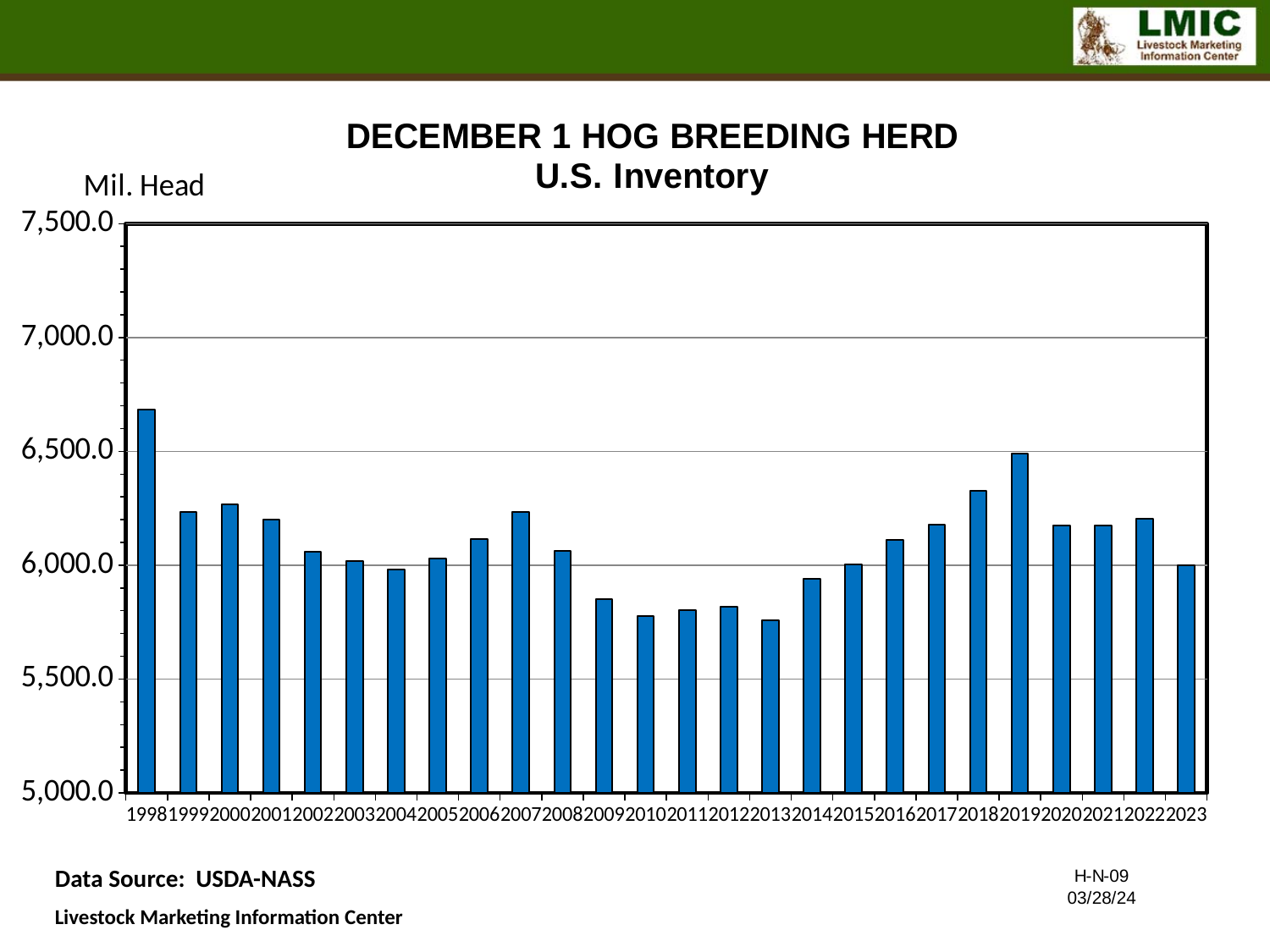
Which year has the highest December 1 hog breeding herd inventory? 1998 Is the value for 2009 greater or less than 6,000? less Is the value for 2013 greater or less than 6,000? less What kind of chart is shown on the slide? bar chart Which is larger, the value for 2017 or the value for 2018? 2018 Which is larger, the value for 1998 or the value for 2019? 1998 Do the values generally rise or fall from 2013 to 2019? rise Is the value for 2018 greater or less than 6,000? greater What unit is shown for the y axis of the chart? Mil. Head How many years are plotted on the x axis of the chart? 26 What is the data source listed below the chart? USDA-NASS